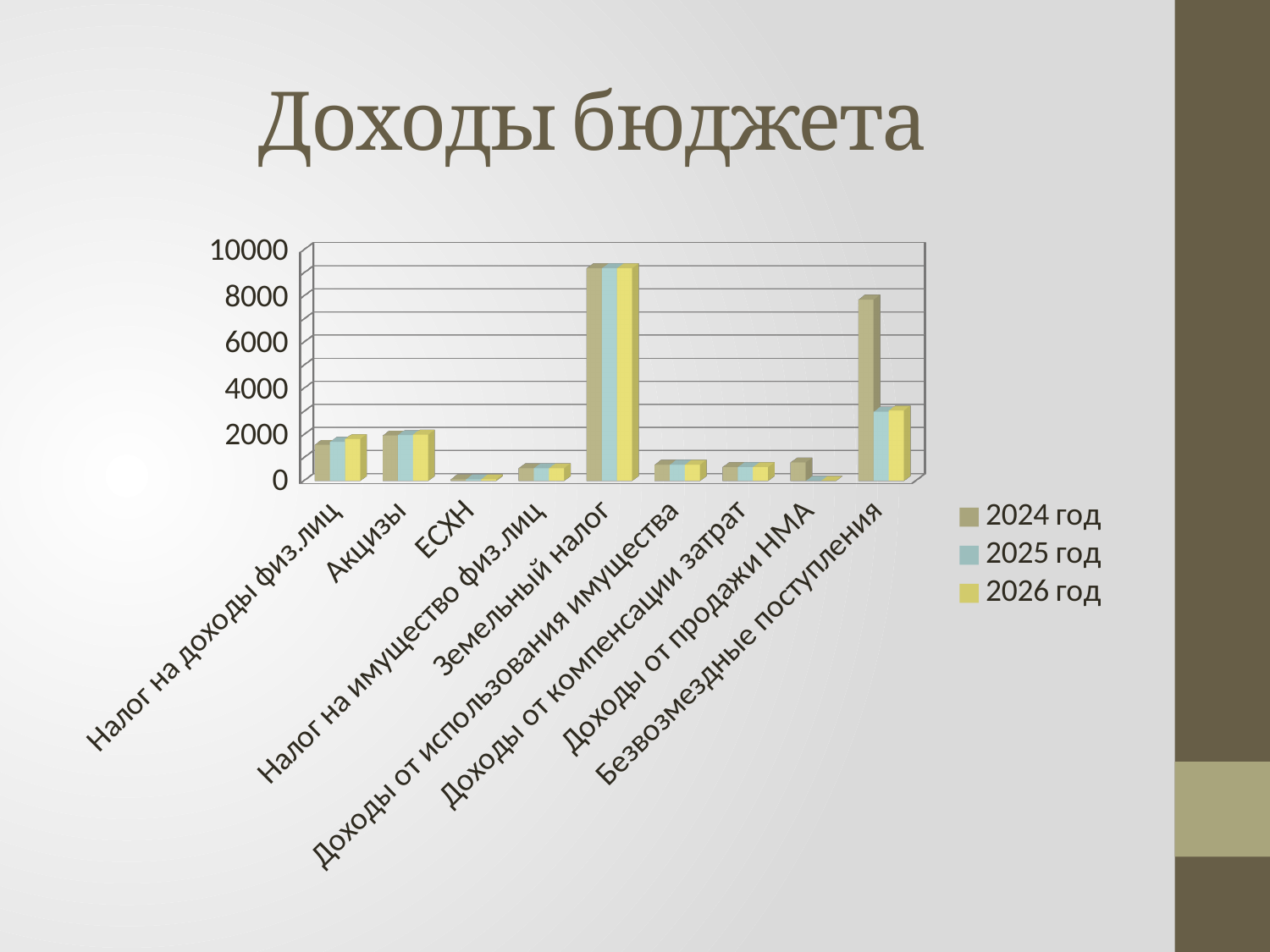
Which series is shown in yellow in the legend? 2026 год Is the value for Земельный налог in 2024 год greater or less than 8000? greater Is the value for Безвозмездные поступления in 2024 год greater or less than 6000? greater Is the value for Акцизы in 2024 год greater or less than 4000? less Which is larger for Безвозмездные поступления: the value for 2024 год or the value for 2025 год? 2024 год How many categories are shown on the x axis? 9 How many series does the legend list? 3 Which is larger: the value for Земельный налог in 2025 год or the value for Акцизы in 2025 год? Земельный налог What kind of chart is shown on the slide? bar chart What is the title of the chart? Доходы бюджета Which category has the highest values across all three years? Земельный налог